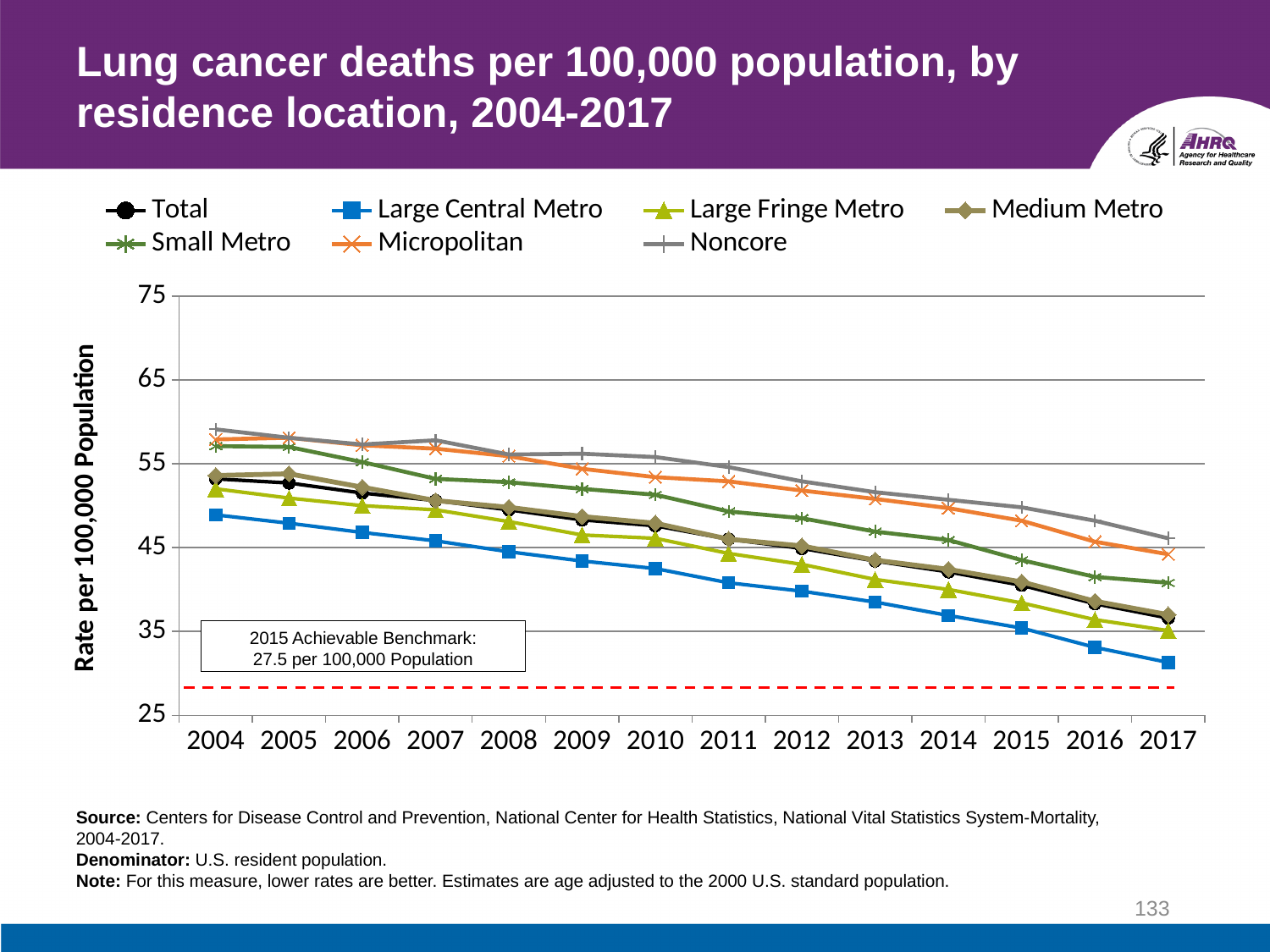
In 2010, which is larger, the rate for Noncore or the rate for Large Central Metro? Noncore Is the value for Noncore in 2004 greater or less than 55? greater How many series does the legend list? 7 What is the 2015 Achievable Benchmark shown on the chart? 27.5 per 100,000 Population Do the lung cancer death rates rise or fall from 2004 to 2017? fall Which residence location has the lowest rate in 2017? Large Central Metro How many years are shown along the x axis? 14 What is the label on the y axis? Rate per 100,000 Population Is the value for Large Fringe Metro in 2012 greater or less than 45? less Is the value for Large Central Metro in 2017 greater or less than 35? less Which residence location has the highest rate in 2004? Noncore What kind of chart is shown on the slide? line chart